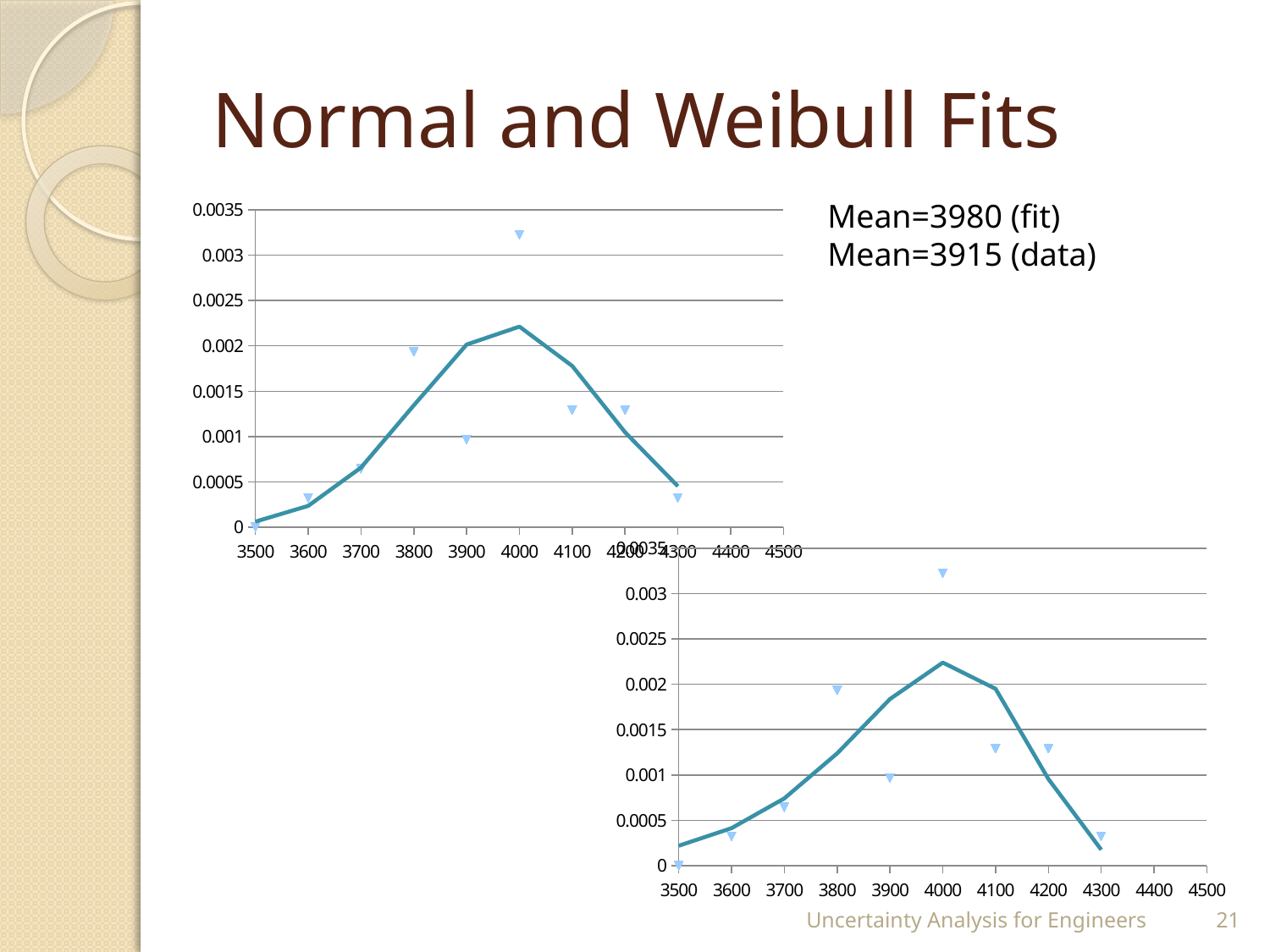
In the top-left chart, is the triangle marker at 4000 greater or less than 0.003? greater In the top-left chart, is the triangle marker at 4100 greater or less than 0.001? greater What is the highest value shown on the y axis of the bottom-right chart? 0.0035 In the bottom-right chart, is the line value at 4300 greater or less than 0.0005? less How many triangle markers are plotted in the top-left chart? 9 In the top-left chart, at which x-axis value does the plotted line reach its peak? 4000 In the bottom-right chart, at which x-axis value is the highest triangle marker? 4000 In the top-left chart, which triangle marker is higher, the one at 3800 or the one at 3900? 3800 What kind of chart is the top-left chart on the slide? line chart In the top-left chart, at which x-axis value is the lowest triangle marker? 3500 In the bottom-right chart, does the plotted line rise or fall between 3500 and 4000 on the x axis? rise